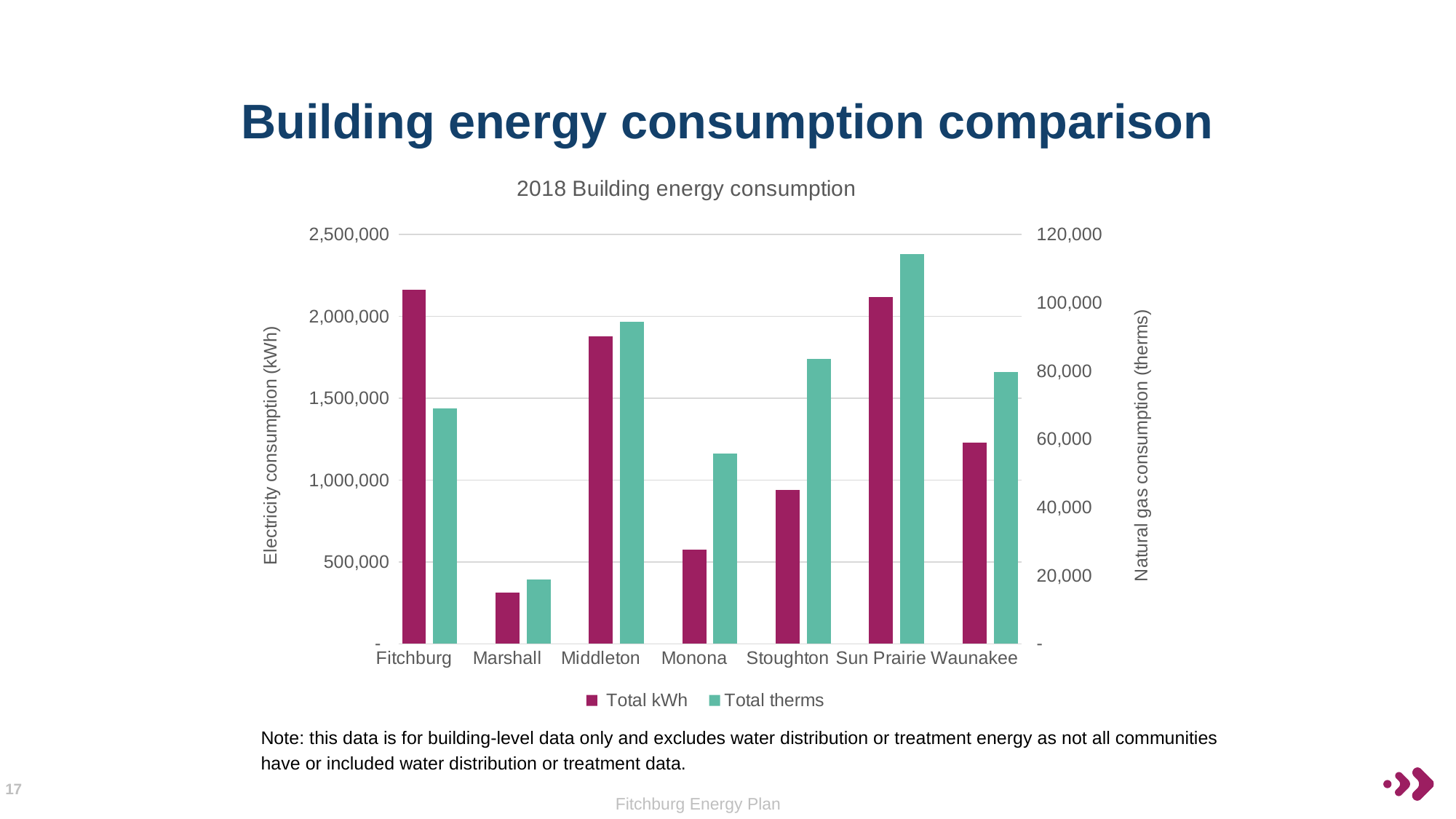
Which community has the highest Total therms value? Sun Prairie What kind of chart is shown on the slide? Bar chart Is the Total kWh value for Fitchburg greater or less than 2,000,000? greater What is the title of the left vertical axis of the chart? Electricity consumption (kWh) Which community has the lowest Total kWh value? Marshall Which is larger, the Total kWh value for Middleton or for Waunakee? Middleton Which community has the lowest Total therms value? Marshall Is the Total therms value for Fitchburg greater or less than 60,000? greater How many communities are shown on the x axis of the chart? 7 Is the Total therms value for Sun Prairie greater or less than 100,000? greater How many series does the chart's legend list? 2